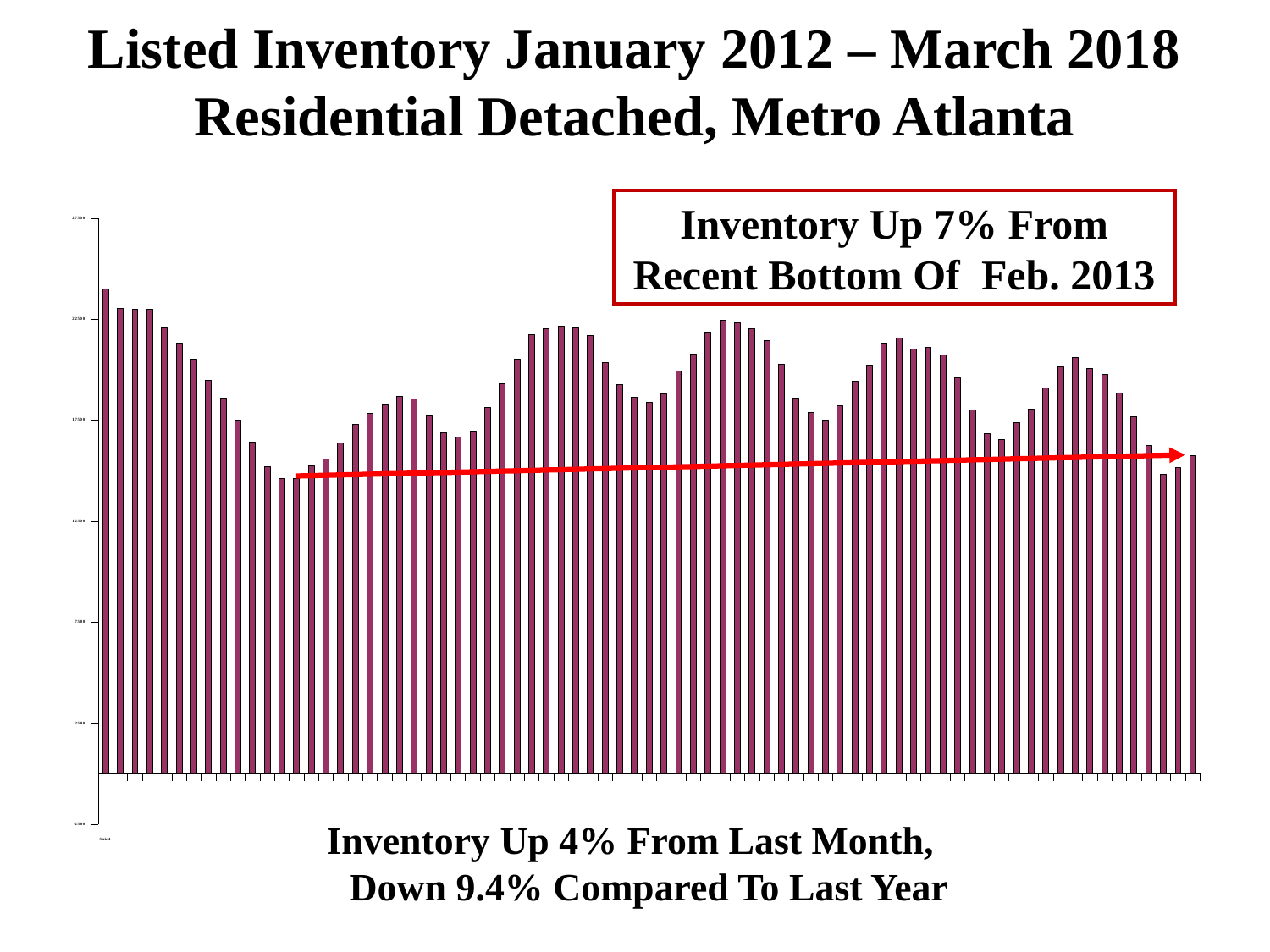
Is the value of the tallest bar greater or less than 22500? greater What does the red-bordered text box on the chart say? Inventory Up 7% From Recent Bottom Of Feb. 2013 Which is larger, the first bar on the left or the last bar on the right? the first bar on the left Comparing the start of the chart to the end, do the inventory values overall rise or fall from left to right? fall What is the title of the chart on the slide? Listed Inventory January 2012 – March 2018 Residential Detached, Metro Atlanta Which bar is the highest in the chart? the first bar on the left (January 2012) Is the value of the last bar on the right (March 2018) greater or less than 17500? less Is the value of the shortest bar greater or less than 17500? less What kind of chart is shown on the slide? bar chart